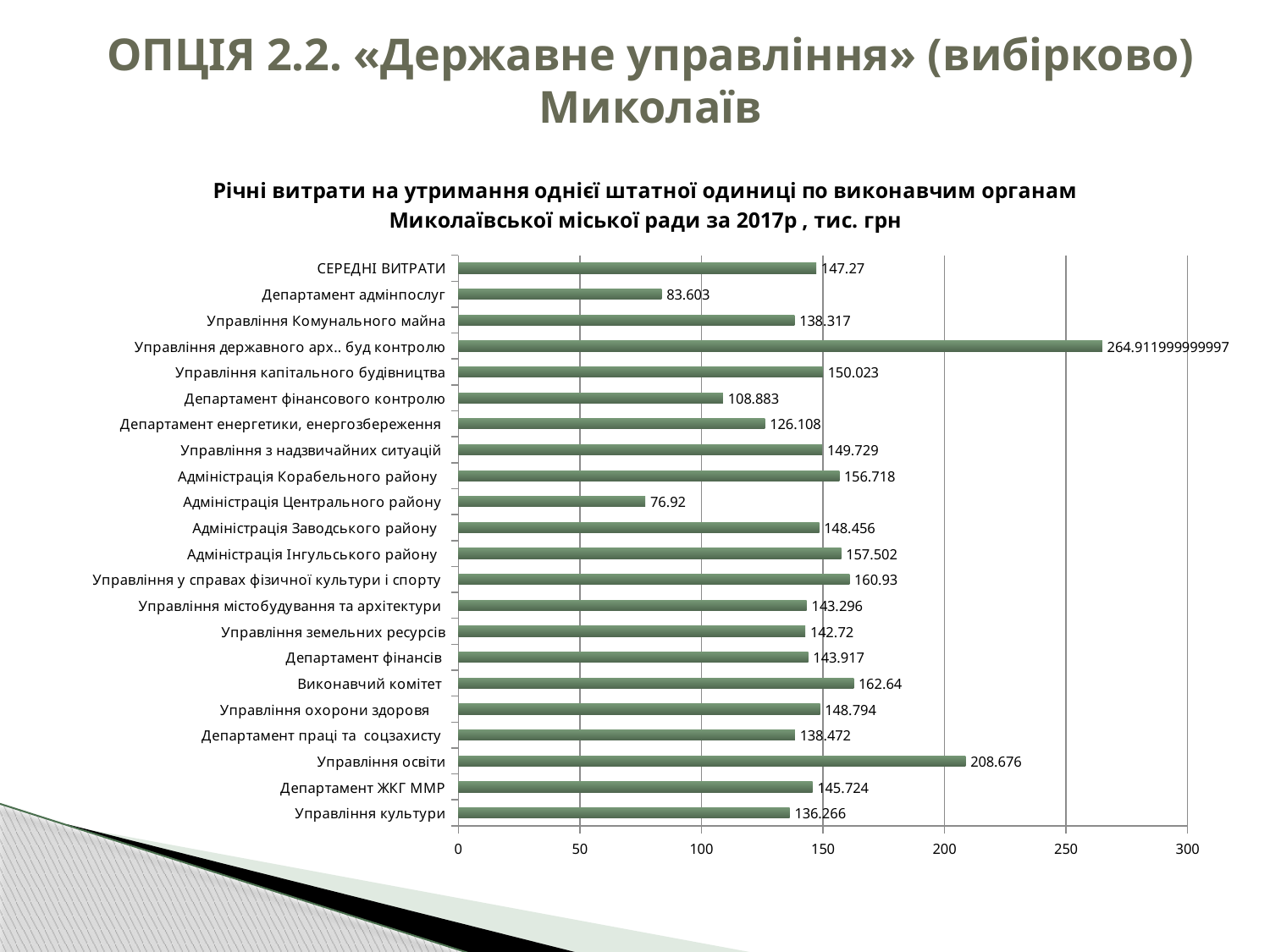
How many categories are shown in the chart? 22 What is the difference between the values for Управління освіти and СЕРЕДНІ ВИТРАТИ? 61.406 Which category has the highest value? Управління державного арх.. буд контролю What is the value for Управління освіти? 208.676 Which category has the lowest value? Адміністрація Центрального району Which is larger, the value for Управління освіти or the value for Виконавчий комітет? Управління освіти What is the value for Виконавчий комітет? 162.64 What kind of chart is shown on the slide? bar chart Is the value for Департамент адмінпослуг greater or less than 100? less What is the value for СЕРЕДНІ ВИТРАТИ? 147.27 What is the value for Департамент адмінпослуг? 83.603 What is the title of the chart? Річні витрати на утримання однієї штатної одиниці по виконавчим органам Миколаївської міської ради за 2017р , тис. грн